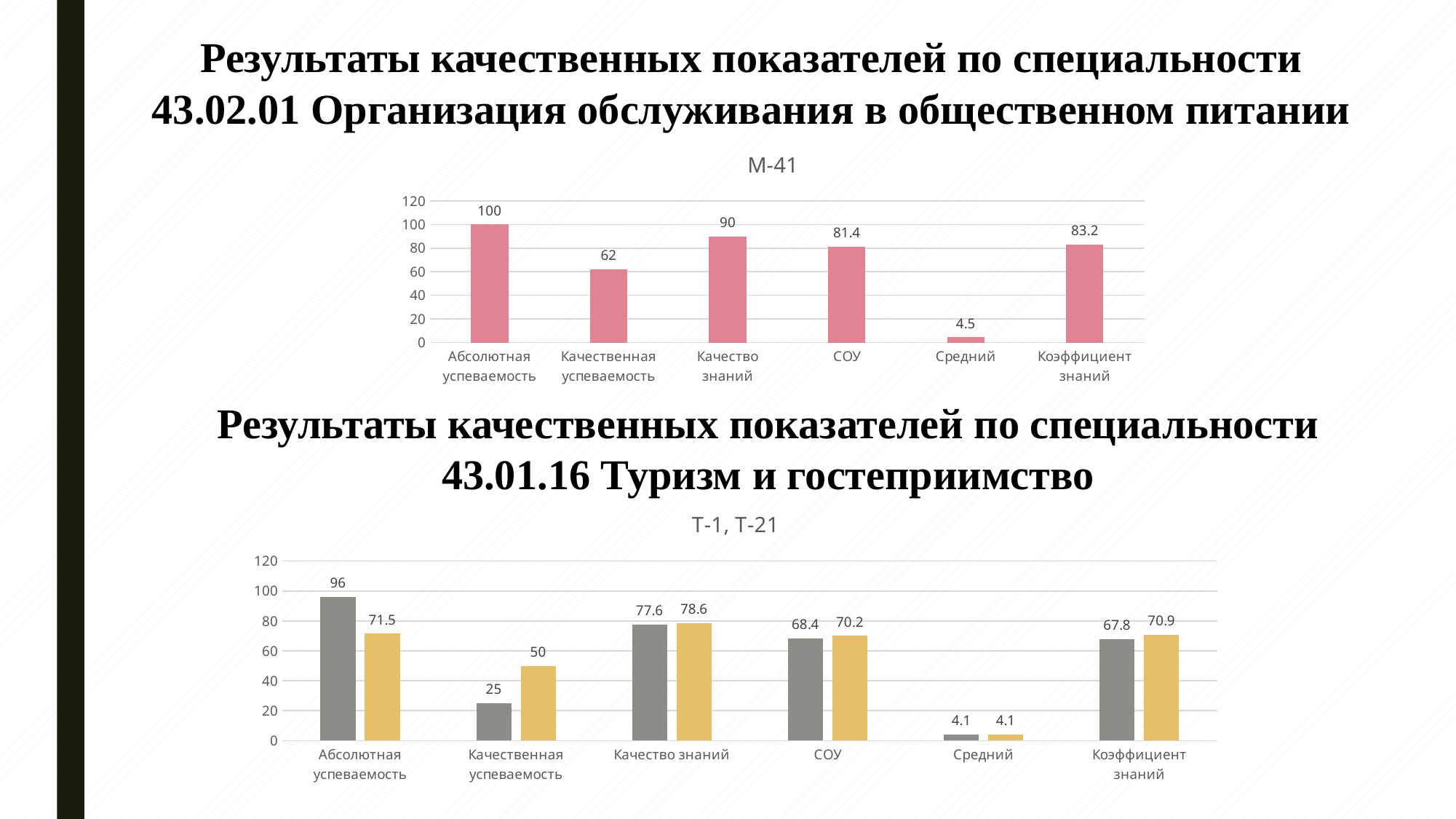
In the chart titled М-41, what is the value for Качественная успеваемость? 62 In the chart titled Т-1, Т-21, what is the difference between the gray and yellow bars for Абсолютная успеваемость? 24.5 In the chart titled М-41, what is the value for Коэффициент знаний? 83.2 In the chart titled М-41, which category has the lowest value? Средний What kind of chart is the chart titled М-41? Bar chart In the chart titled М-41, what is the difference between Качество знаний and СОУ? 8.6 In the chart titled Т-1, Т-21, which is larger for Качество знаний: the gray bar or the yellow bar? The yellow bar In the chart titled Т-1, Т-21, how many bars are shown for each category? 2 In the chart titled М-41, how many categories are shown on the x axis? 6 In the chart titled М-41, which category has the highest value? Абсолютная успеваемость In the chart titled Т-1, Т-21, what is the value of the yellow bar for Качественная успеваемость? 50 In the chart titled Т-1, Т-21, what is the value of the gray bar for Абсолютная успеваемость? 96